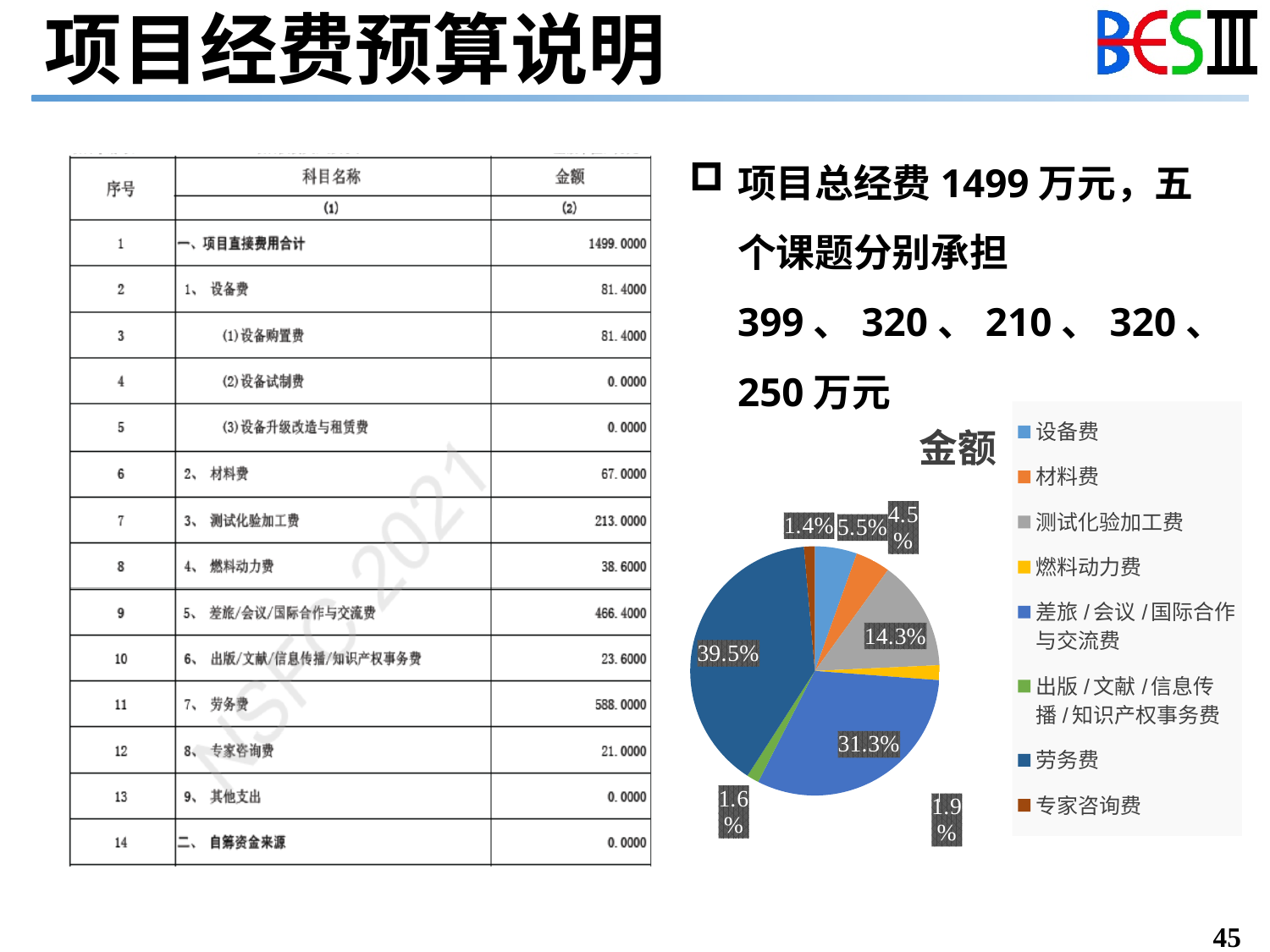
What share of the pie does 劳务费 account for? 39.5% Which category has the largest share of the pie chart? 劳务费 What is the difference in percentage points between the shares of 劳务费 and 差旅/会议/国际合作与交流费? 8.2 What share of the pie does 材料费 account for? 4.5% What kind of chart is shown on the slide? Pie chart How many categories does the legend of the pie chart list? 8 Which has the larger share of the pie, 设备费 or 材料费? 设备费 What share of the pie does 测试化验加工费 account for? 14.3% What is the title of the pie chart? 金额 Which category has the smallest share of the pie chart? 专家咨询费